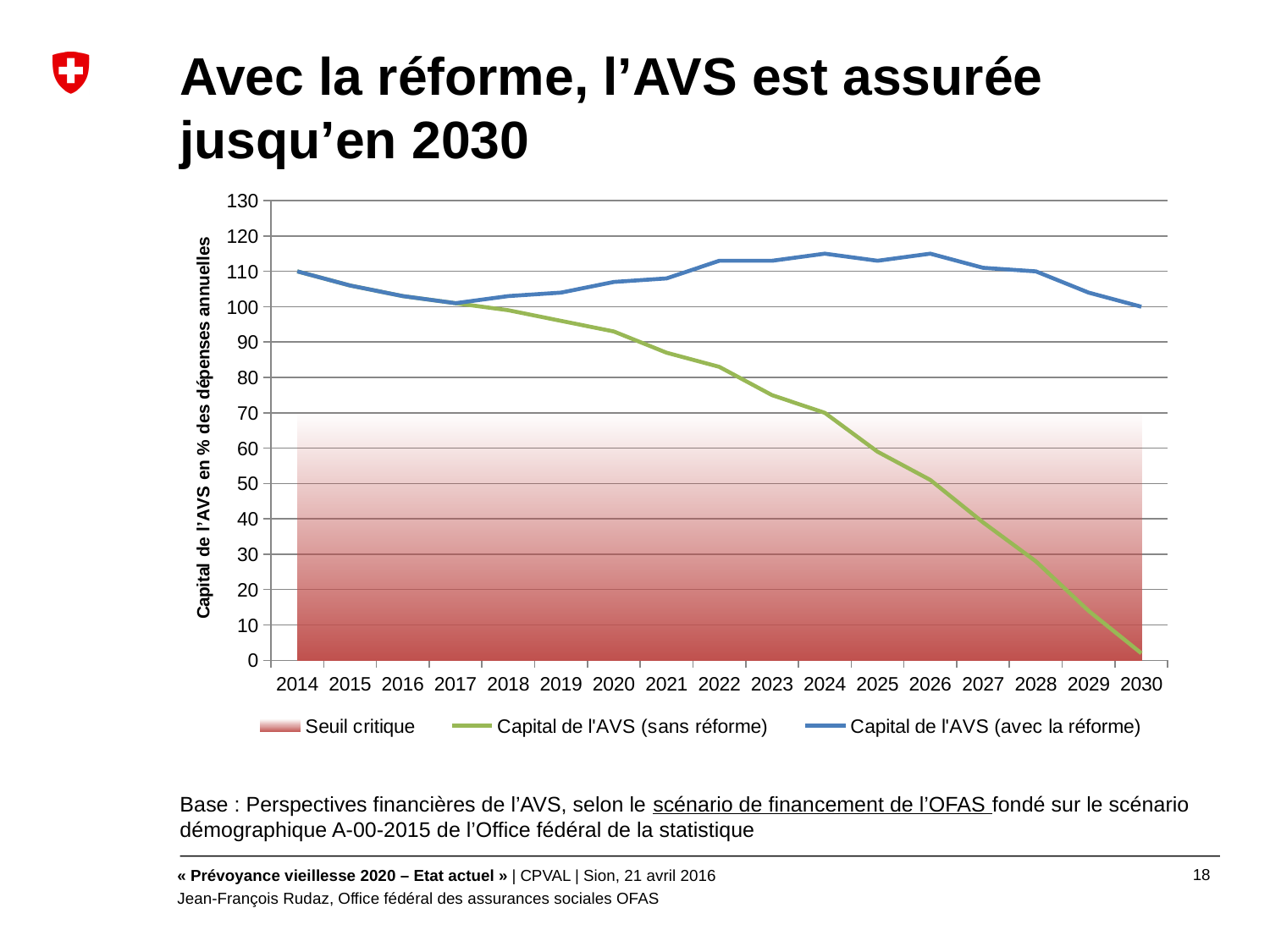
What is the label of the y axis? Capital de l'AVS en % des dépenses annuelles In 2030, which series is larger: 'Capital de l'AVS (sans réforme)' or 'Capital de l'AVS (avec la réforme)'? Capital de l'AVS (avec la réforme) What is the value of 'Capital de l'AVS (avec la réforme)' in 2030? 100 What kind of chart is shown on the slide? line chart Is the value for 'Capital de l'AVS (sans réforme)' in 2028 greater or less than 40? less Is the value for 'Capital de l'AVS (sans réforme)' in 2020 greater or less than 90? greater How many years are shown on the x axis? 17 How many entries does the legend list? 3 Does 'Capital de l'AVS (sans réforme)' rise or fall from 2017 to 2030? fall Is the value for 'Capital de l'AVS (avec la réforme)' in 2024 greater or less than 110? greater In which year is 'Capital de l'AVS (sans réforme)' at its lowest? 2030